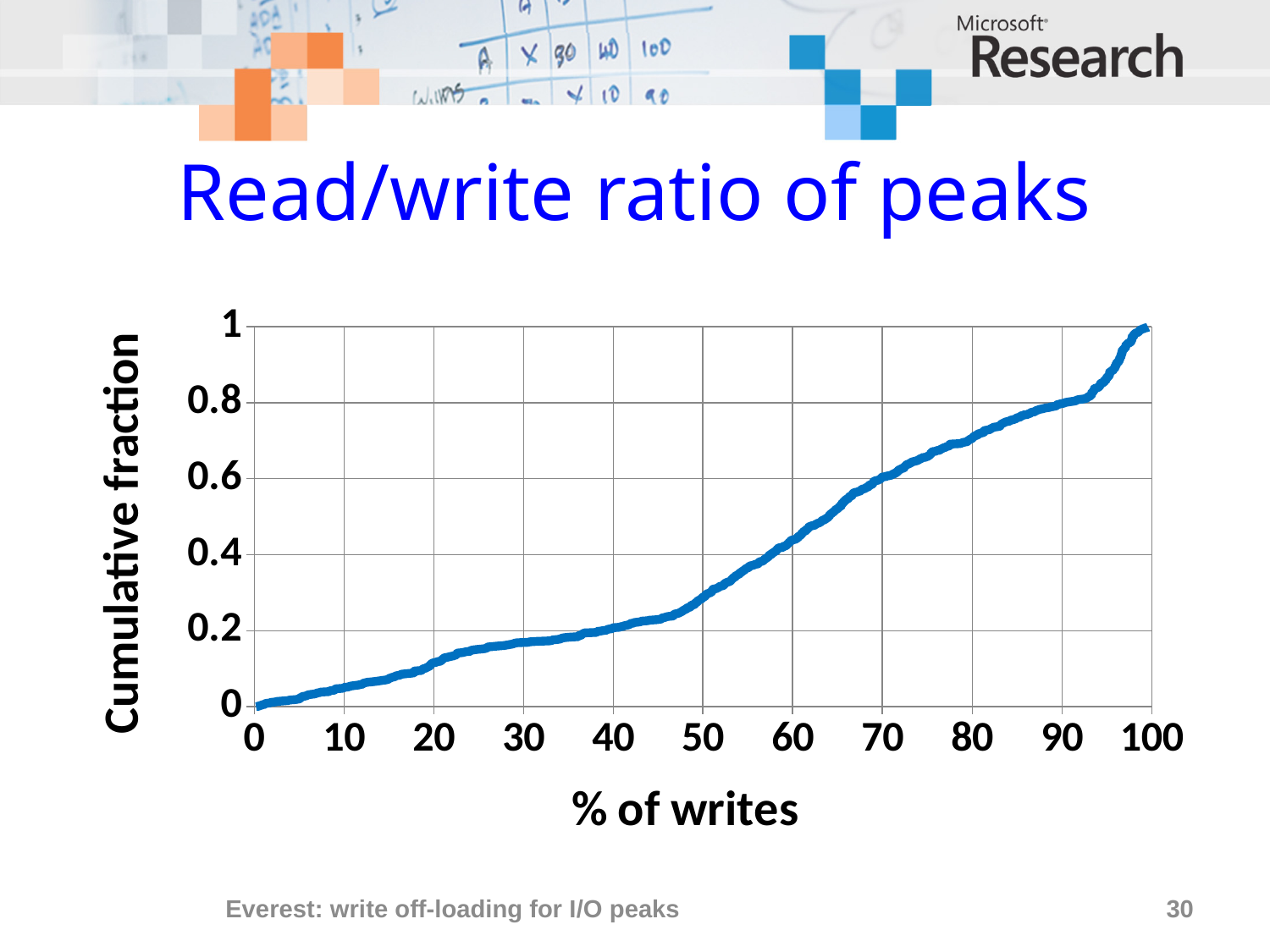
Does the cumulative fraction rise or fall as % of writes increases from 0 to 100? rise Is the cumulative fraction at 90% of writes greater or less than 0.6? greater Is the cumulative fraction at 20% of writes greater or less than 0.2? less What kind of chart is shown on the slide? line chart What is the label of the x axis of the chart? % of writes Is the cumulative fraction at 50% of writes greater or less than 0.2? greater What is the label of the y axis of the chart? Cumulative fraction